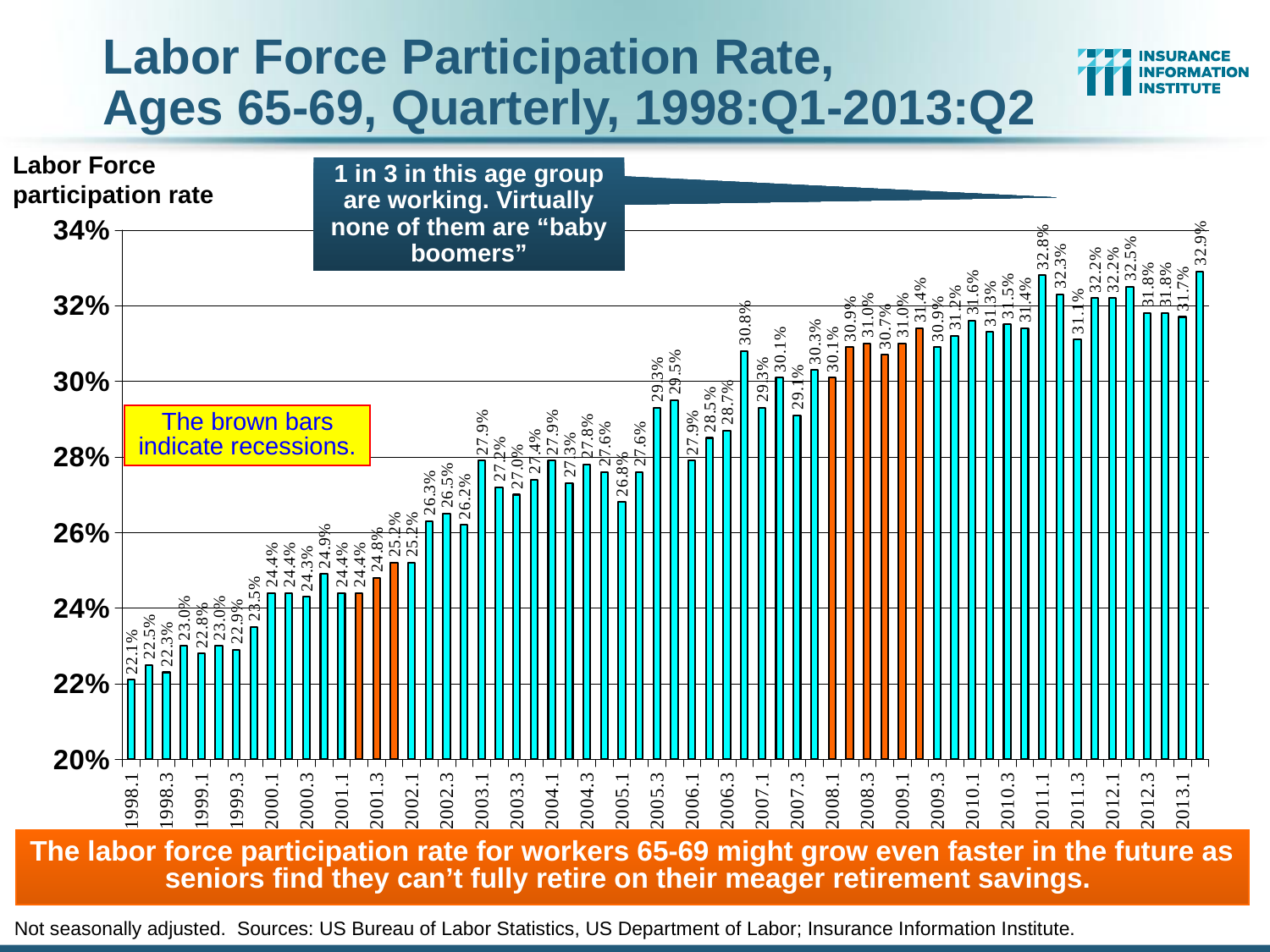
Which is larger, the rate for 2005.1 or the rate for 2005.3? 2005.3 According to the slide, what do the brown bars indicate? Recessions What is the labor force participation rate shown for 2008.1? 30.1% What is the labor force participation rate shown for 2011.1? 32.8% What is the labor force participation rate shown for 1998.1? 22.1% By how many percentage points does the rate for 2013.1 exceed the rate for 1998.1? 9.6 percentage points What kind of chart is used on this slide? Bar chart What is the difference between the rates for 2011.1 and 2011.3? 1.7 percentage points Which quarter has the lowest labor force participation rate on the chart? 1998.1 Does the labor force participation rate generally rise or fall from 1998 to 2013? Rise What is the highest labor force participation rate value shown on the chart? 32.9% What is the labor force participation rate shown for 2013.1? 31.7%